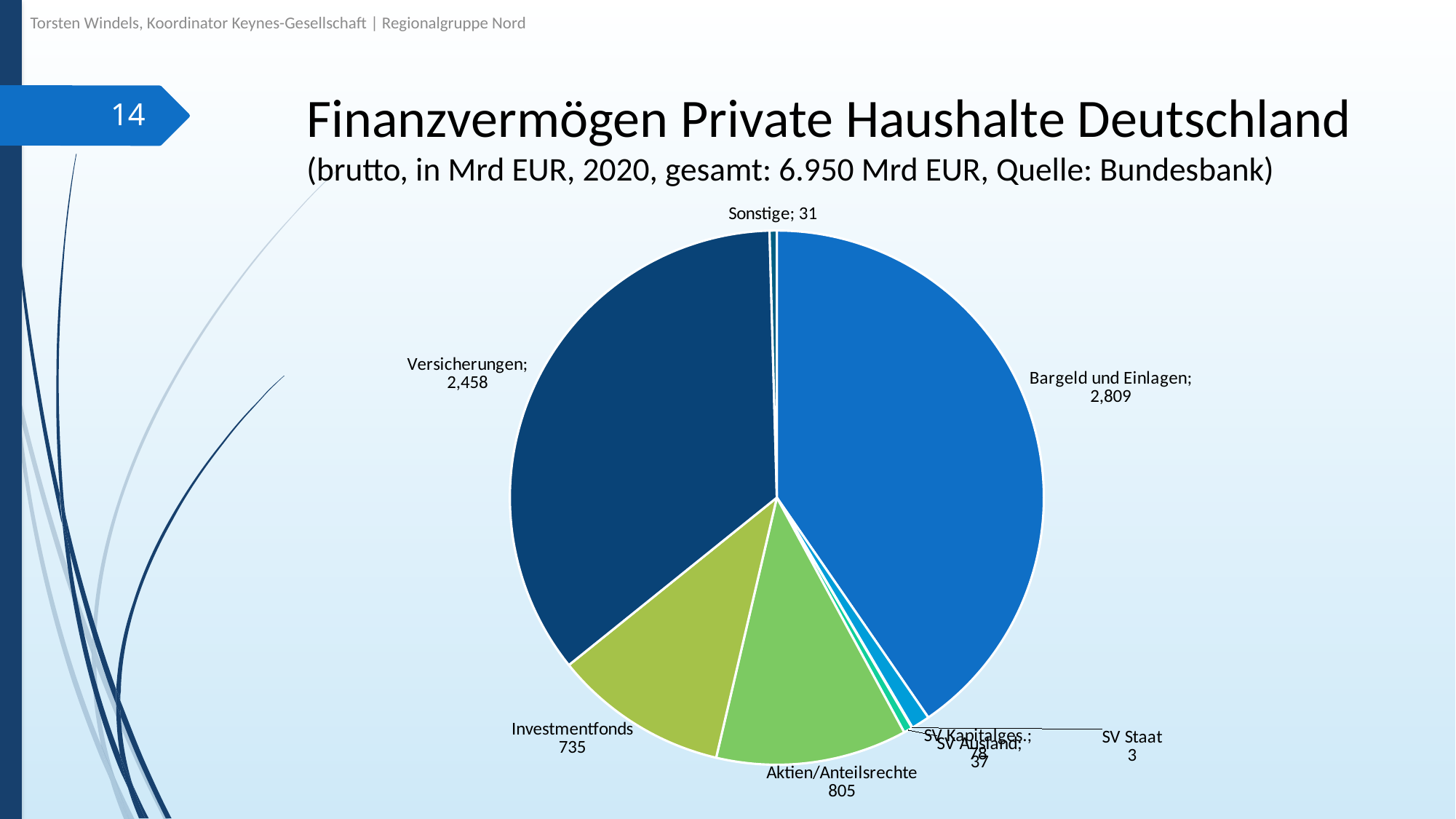
Which category has the largest slice of the pie? Bargeld und Einlagen According to the subtitle, what is the total financial wealth shown in the chart? 6.950 Mrd EUR What is the value for Aktien/Anteilsrechte? 805 What is the value for Versicherungen? 2,458 Which is larger, Aktien/Anteilsrechte or Investmentfonds? Aktien/Anteilsrechte What is the difference between Bargeld und Einlagen and Versicherungen? 351 How many slices does the pie chart have? 8 What is the value for Bargeld und Einlagen? 2,809 What is the value for Investmentfonds? 735 What is the value for Sonstige? 31 Which category has the smallest value in the pie chart? SV Staat What kind of chart is shown on the slide? pie chart